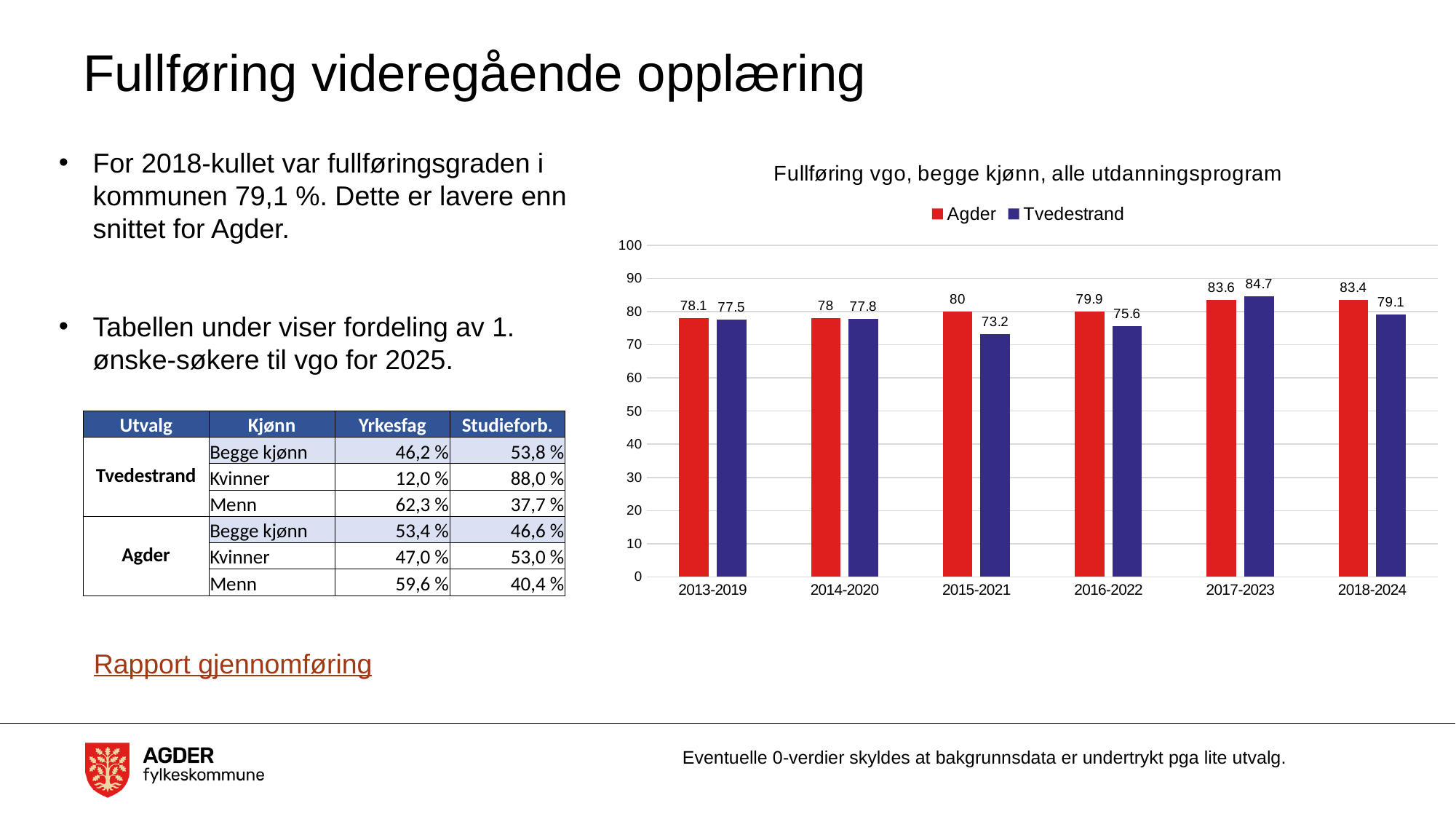
What is the value for Agder in 2015-2021? 80 What is the difference between Agder and Tvedestrand in 2015-2021? 6.8 How many periods are shown on the x axis? 6 How many series does the legend list? 2 What is the value for Tvedestrand in 2015-2021? 73.2 Which period has the highest value for Agder? 2017-2023 What is the value for Tvedestrand in 2018-2024? 79.1 Which period has the highest value for Tvedestrand? 2017-2023 Which is larger in 2017-2023, Agder or Tvedestrand? Tvedestrand What kind of chart is shown? bar chart Is the value for Tvedestrand in 2016-2022 greater or less than 80? less Which period has the lowest value for Tvedestrand? 2015-2021